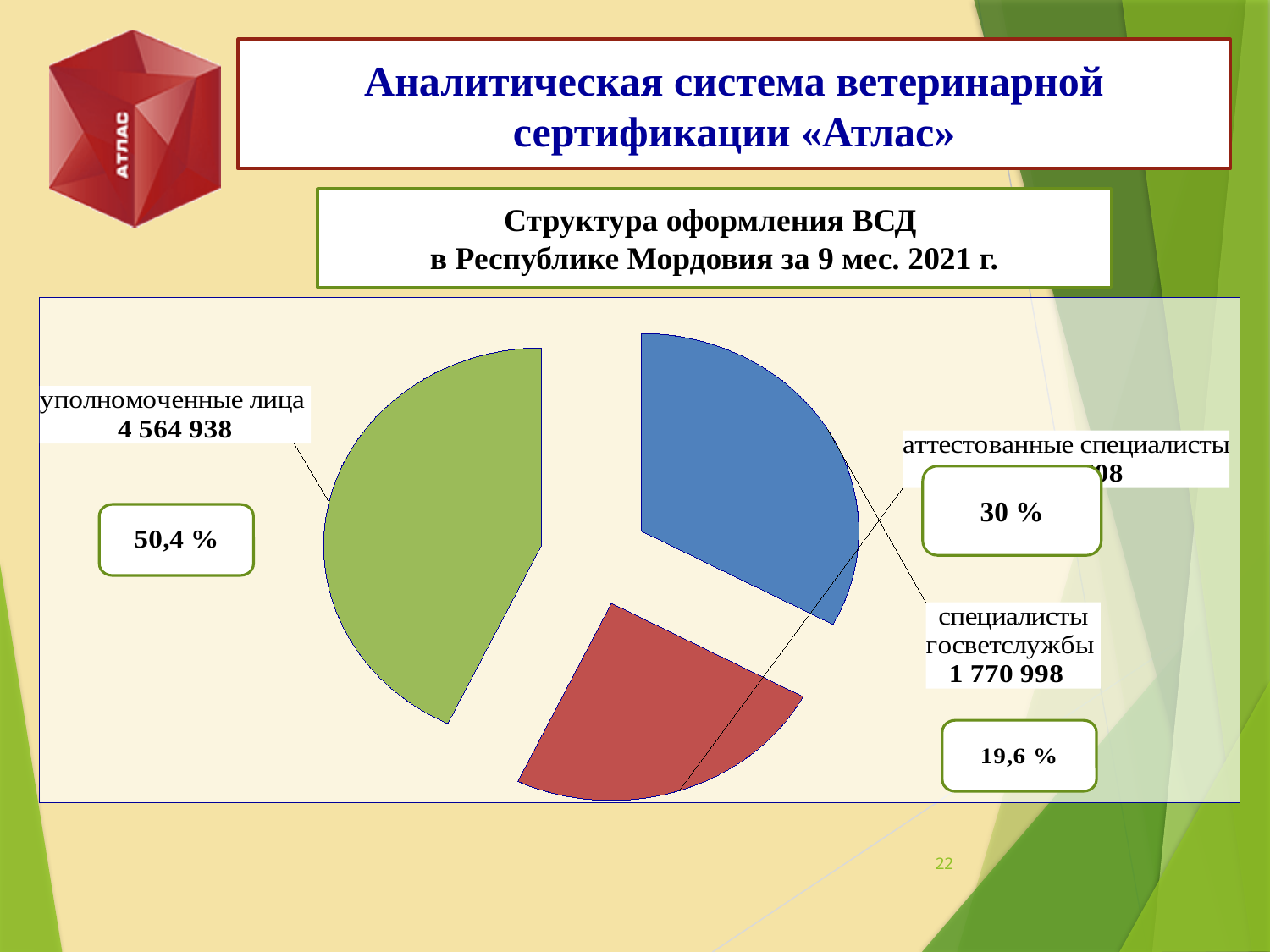
What colour is the slice for уполномоченные лица? green What is the difference between the values for уполномоченные лица and специалисты госветслужбы? 2 793 940 What is the value for уполномоченные лица? 4 564 938 Which category has the largest slice of the pie? уполномоченные лица How many slices does the pie chart have? 3 What share of the pie does уполномоченные лица represent? 50,4 % What kind of chart is shown on the slide? pie chart What share of the pie does специалисты госветслужбы represent? 19,6 % Which category has the smallest slice of the pie? специалисты госветслужбы What share of the pie does аттестованные специалисты represent? 30 % What is the value for специалисты госветслужбы? 1 770 998 Which is larger, the slice for аттестованные специалисты or the slice for специалисты госветслужбы? аттестованные специалисты